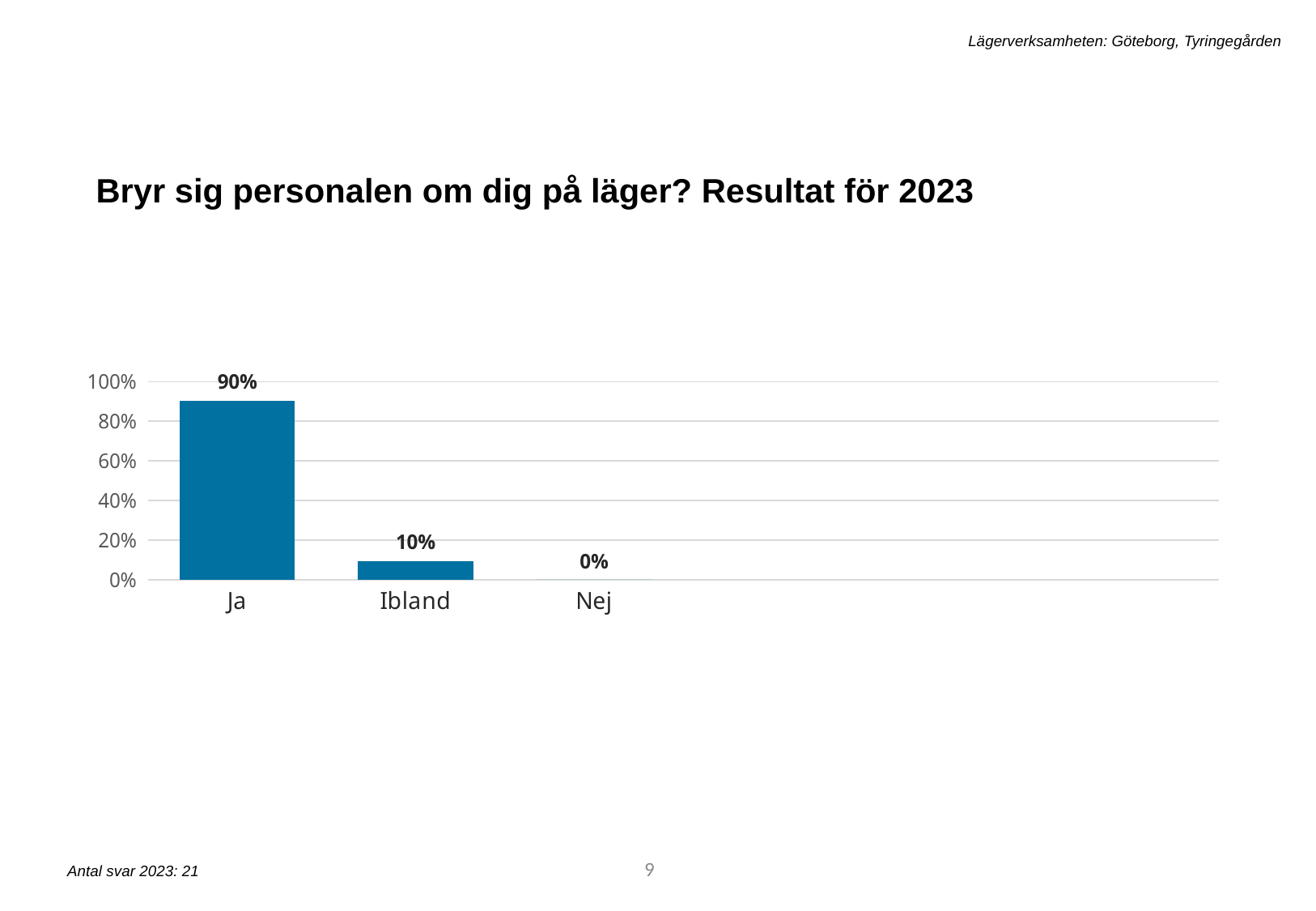
What is the difference between the values for Ja and Ibland? 80% Do the values rise or fall from left to right along the x axis? fall Which category has the lowest value? Nej What is the value for Ja? 90% What is the title of the slide above the chart? Bryr sig personalen om dig på läger? Resultat för 2023 What kind of chart is shown on the slide? bar chart How many categories are shown on the x axis? 3 Which category has the highest value? Ja What is the value for Ibland? 10% What is the value for Nej? 0% Which is larger, the value for Ibland or the value for Nej? Ibland Is the value for Ja greater or less than 80%? greater